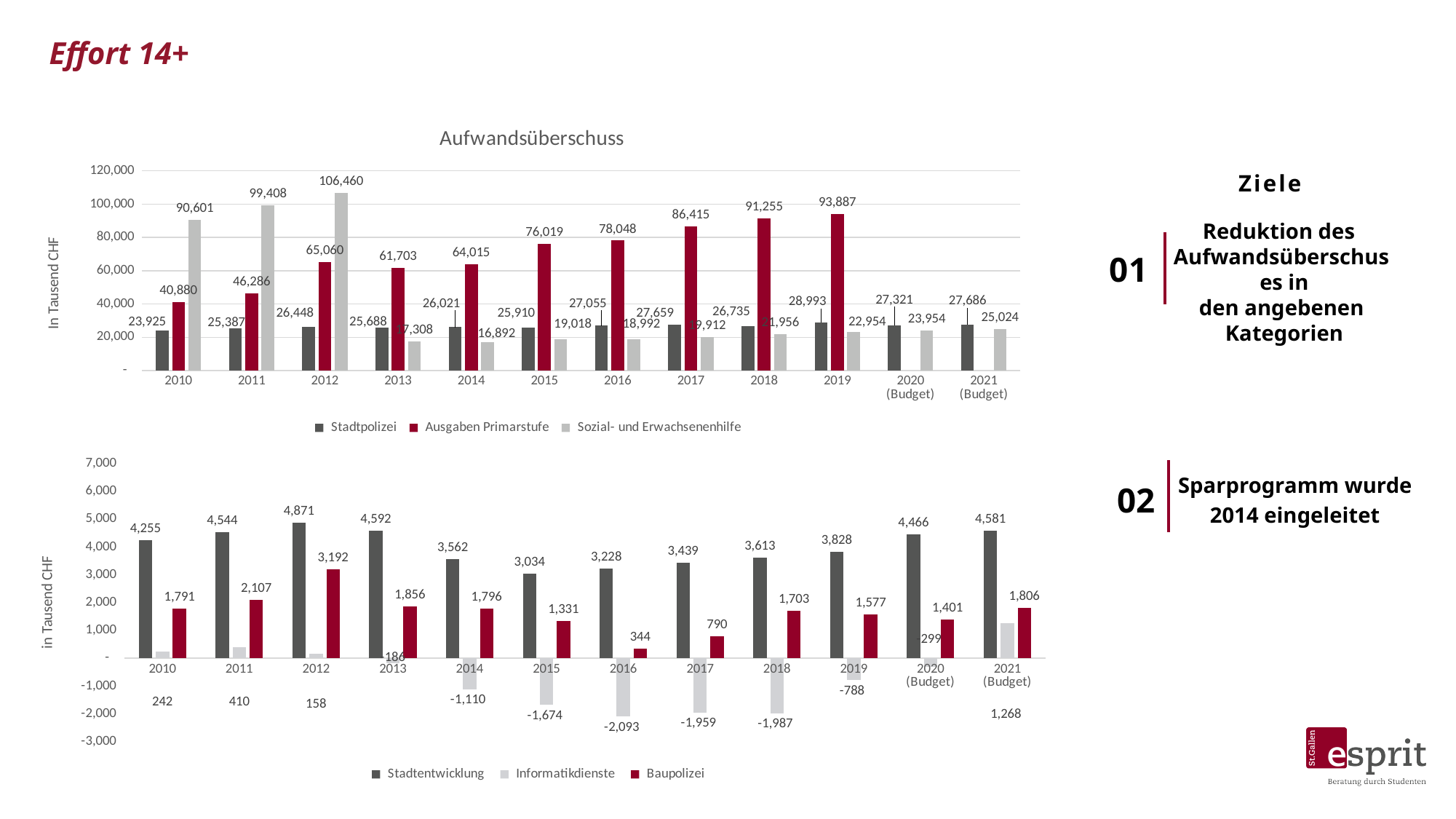
In the top chart titled Aufwandsüberschuss, in which year is Ausgaben Primarstufe highest? 2019 In the bottom chart, in which year is Baupolizei lowest? 2016 In the top chart titled Aufwandsüberschuss, what is the difference between Ausgaben Primarstufe in 2019 and in 2010? 53,007 In the top chart titled Aufwandsüberschuss, which is larger in 2011: Ausgaben Primarstufe or Sozial- und Erwachsenenhilfe? Sozial- und Erwachsenenhilfe In the bottom chart, what is the value for Informatikdienste in 2016? -2,093 In the top chart titled Aufwandsüberschuss, what is the value for Sozial- und Erwachsenenhilfe in 2012? 106,460 In the bottom chart, what is the difference between Stadtentwicklung and Baupolizei in 2021 (Budget)? 2,775 What kind of chart is the bottom chart? Bar chart In the top chart titled Aufwandsüberschuss, what is the value for Ausgaben Primarstufe in 2019? 93,887 In the top chart titled Aufwandsüberschuss, how many series does the legend list? 3 In the bottom chart, how many years are shown on the x axis? 12 In the bottom chart, what is the value for Stadtentwicklung in 2012? 4,871